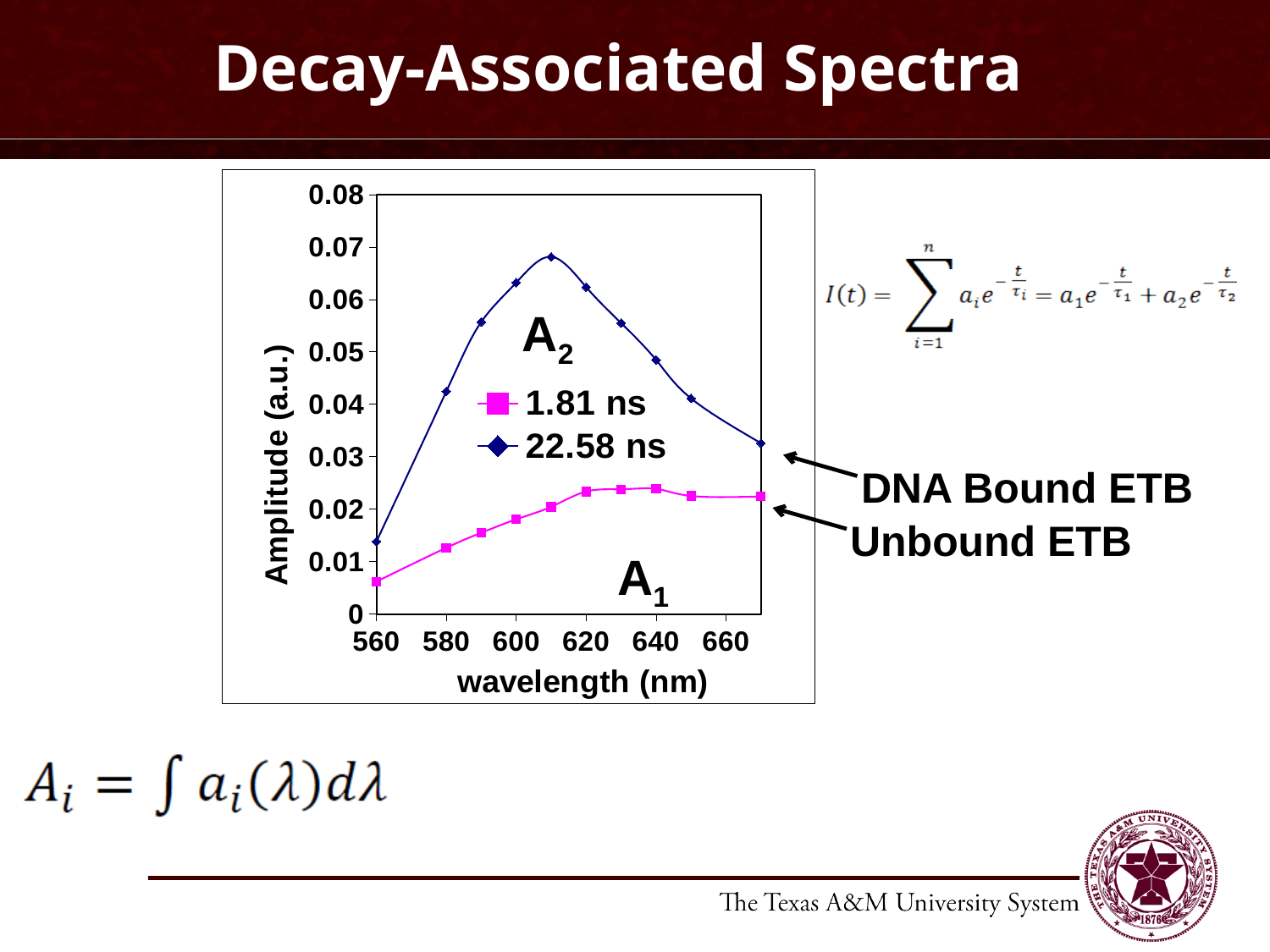
Does the amplitude of the 1.81 ns series rise or fall from 560 nm to 640 nm? rise What is the title of the x axis of the chart? wavelength (nm) How many series does the chart legend list? 2 Is the amplitude of the 22.58 ns series at 610 nm greater or less than 0.06? greater Is the amplitude of the 1.81 ns series at 560 nm greater or less than 0.01? less Which series reaches the higher peak amplitude, 1.81 ns or 22.58 ns? 22.58 ns What kind of chart is shown on the slide? line chart Is the amplitude of the 1.81 ns series at 640 nm greater or less than 0.02? greater Does the amplitude of the 22.58 ns series rise or fall from 610 nm to 670 nm? fall What are the two series named in the chart legend? 1.81 ns and 22.58 ns At 610 nm, which series has the larger amplitude, 1.81 ns or 22.58 ns? 22.58 ns